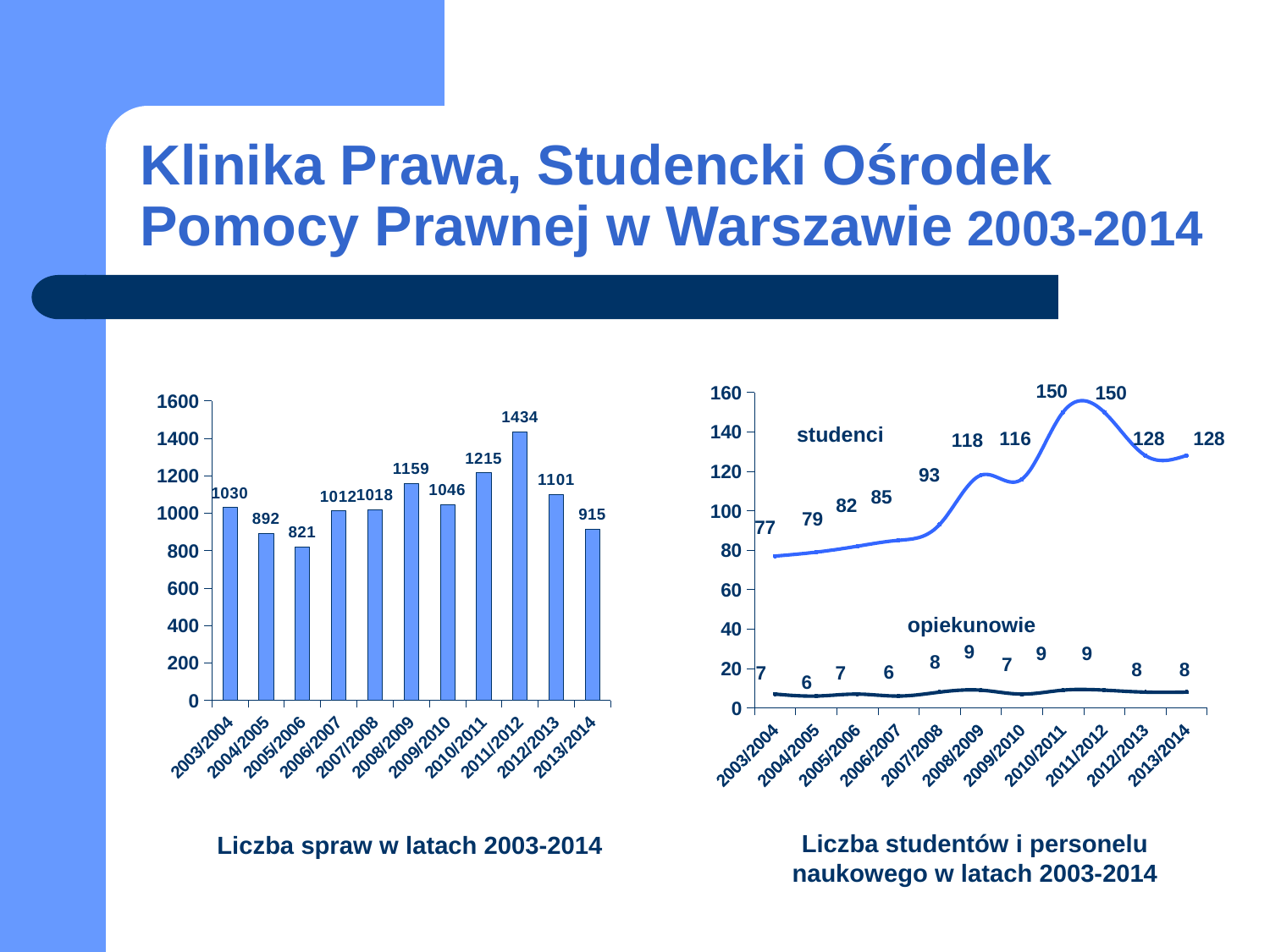
In the right chart (Liczba studentów i personelu naukowego w latach 2003-2014), what is the difference between the studenci values for 2010/2011 and 2003/2004? 73 In the right chart (Liczba studentów i personelu naukowego w latach 2003-2014), how many series are plotted? 2 What kind of chart is the right chart (Liczba studentów i personelu naukowego w latach 2003-2014)? line chart In the left chart (Liczba spraw w latach 2003-2014), what is the difference between the values for 2011/2012 and 2013/2014? 519 What kind of chart is the left chart (Liczba spraw w latach 2003-2014)? bar chart In the left chart (Liczba spraw w latach 2003-2014), which is larger, the value for 2003/2004 or the value for 2009/2010? 2009/2010 In the left chart (Liczba spraw w latach 2003-2014), which year has the lowest number of cases? 2005/2006 In the left chart (Liczba spraw w latach 2003-2014), what is the value for 2011/2012? 1434 In the left chart (Liczba spraw w latach 2003-2014), which year has the highest number of cases? 2011/2012 In the left chart (Liczba spraw w latach 2003-2014), how many years are shown on the x axis? 11 In the right chart (Liczba studentów i personelu naukowego w latach 2003-2014), what is the value for studenci in 2008/2009? 118 In the right chart (Liczba studentów i personelu naukowego w latach 2003-2014), what is the value for opiekunowie in 2004/2005? 6